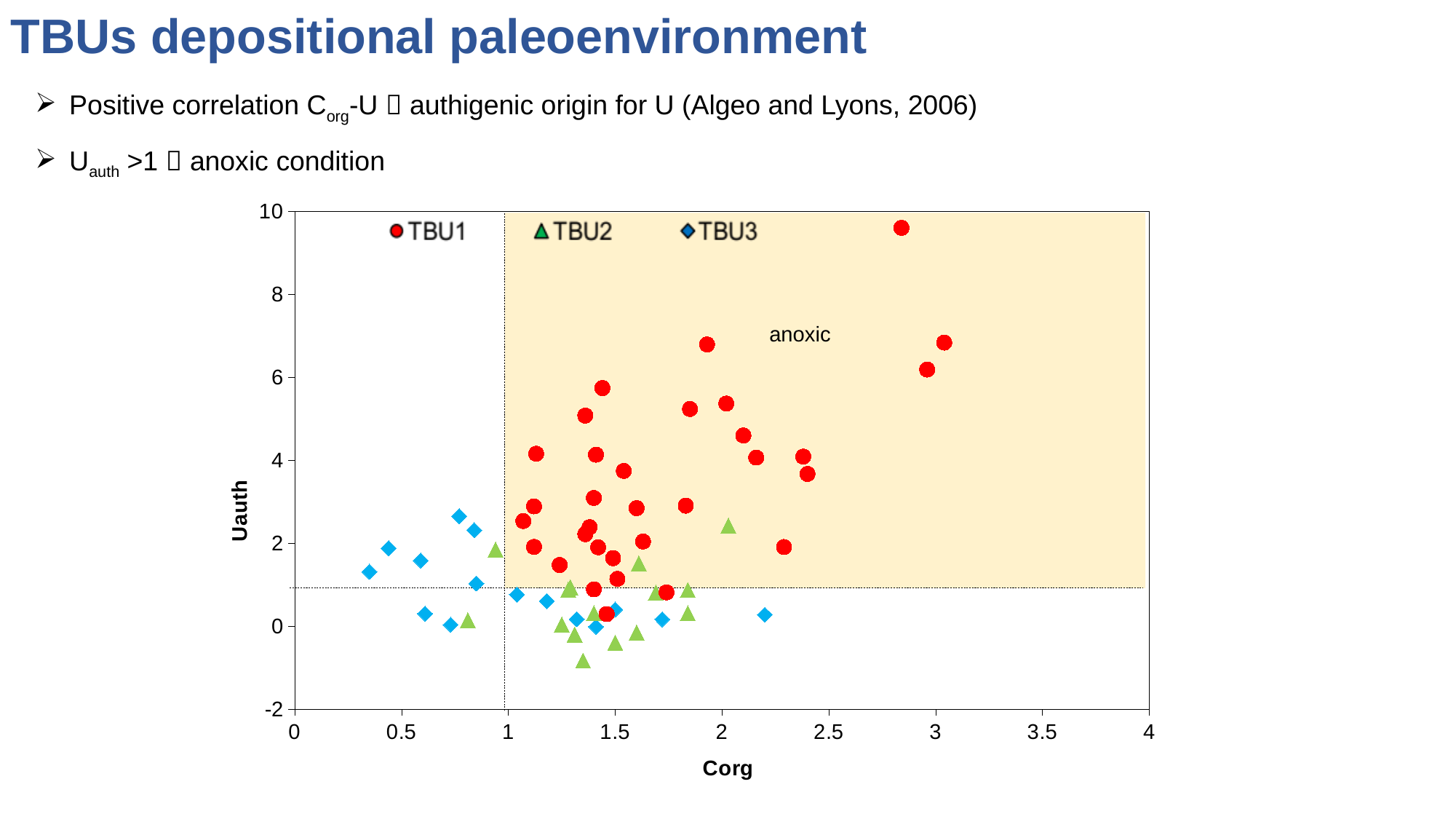
Is the highest Uauth value among the TBU3 points greater or less than 4? less Is the highest Uauth value among the TBU1 points greater or less than 8? greater What kind of chart is shown on the slide? scatter chart Is the largest Corg value among the TBU1 points greater or less than 2.5? greater Which series contains the point with the lowest Uauth value? TBU2 How many series does the legend list? 3 What are the three series names listed in the legend? TBU1, TBU2, TBU3 Which series reaches higher Uauth values, TBU1 or TBU3? TBU1 What label is written inside the shaded region of the chart? anoxic Which series contains the point with the highest Uauth value? TBU1